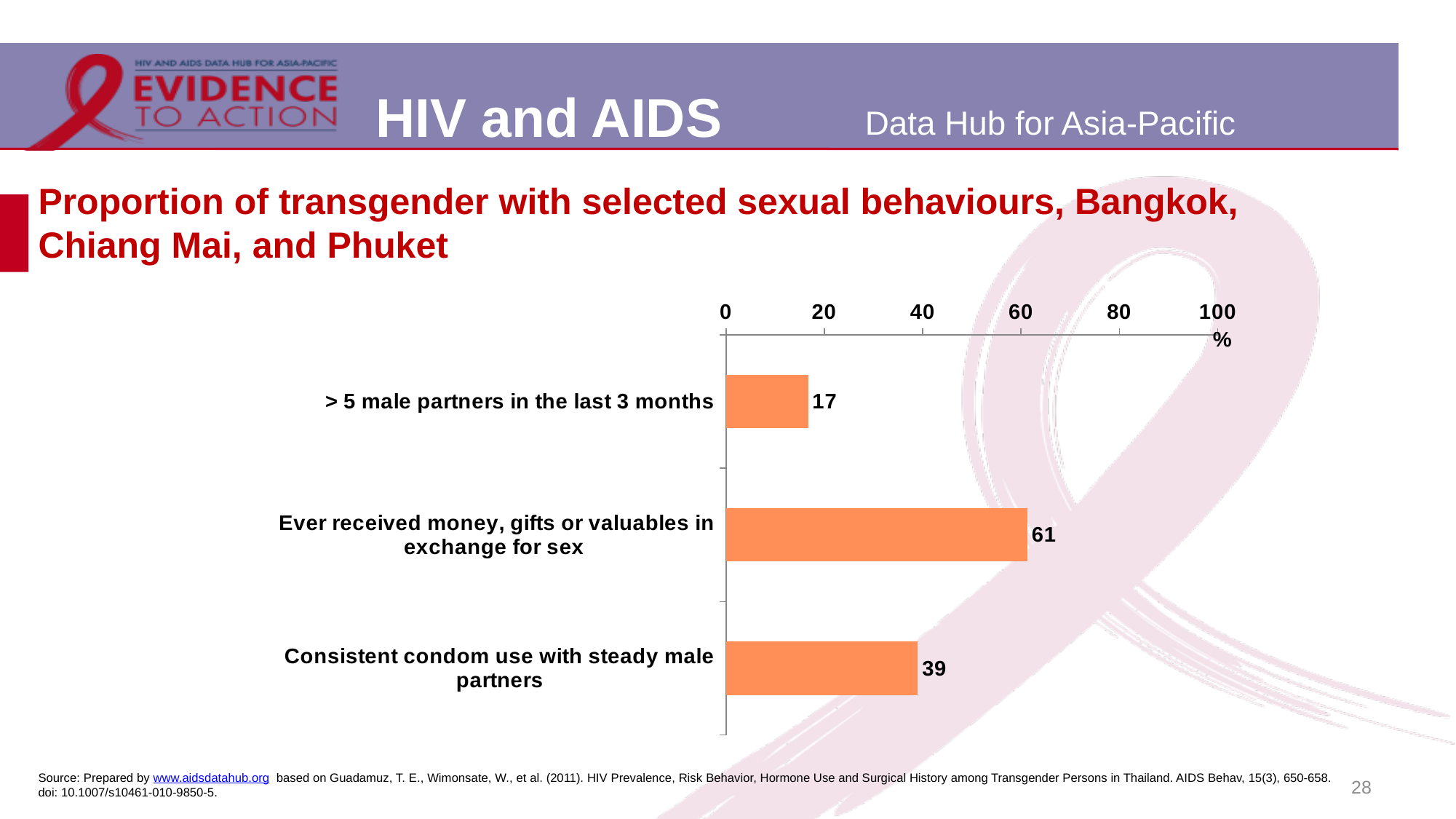
How many categories are shown in the chart? 3 What is the value for 'Ever received money, gifts or valuables in exchange for sex'? 61 What is the value for '> 5 male partners in the last 3 months'? 17 What kind of chart is shown on the slide? Bar chart What is the difference between the values for 'Ever received money, gifts or valuables in exchange for sex' and 'Consistent condom use with steady male partners'? 22 What unit is shown on the chart's axis? % What is the difference between the values for 'Consistent condom use with steady male partners' and '> 5 male partners in the last 3 months'? 22 Which is larger: the value for 'Consistent condom use with steady male partners' or '> 5 male partners in the last 3 months'? Consistent condom use with steady male partners Is the value for 'Ever received money, gifts or valuables in exchange for sex' greater or less than 60? greater Which category has the highest value? Ever received money, gifts or valuables in exchange for sex What is the value for 'Consistent condom use with steady male partners'? 39 Which category has the lowest value? > 5 male partners in the last 3 months